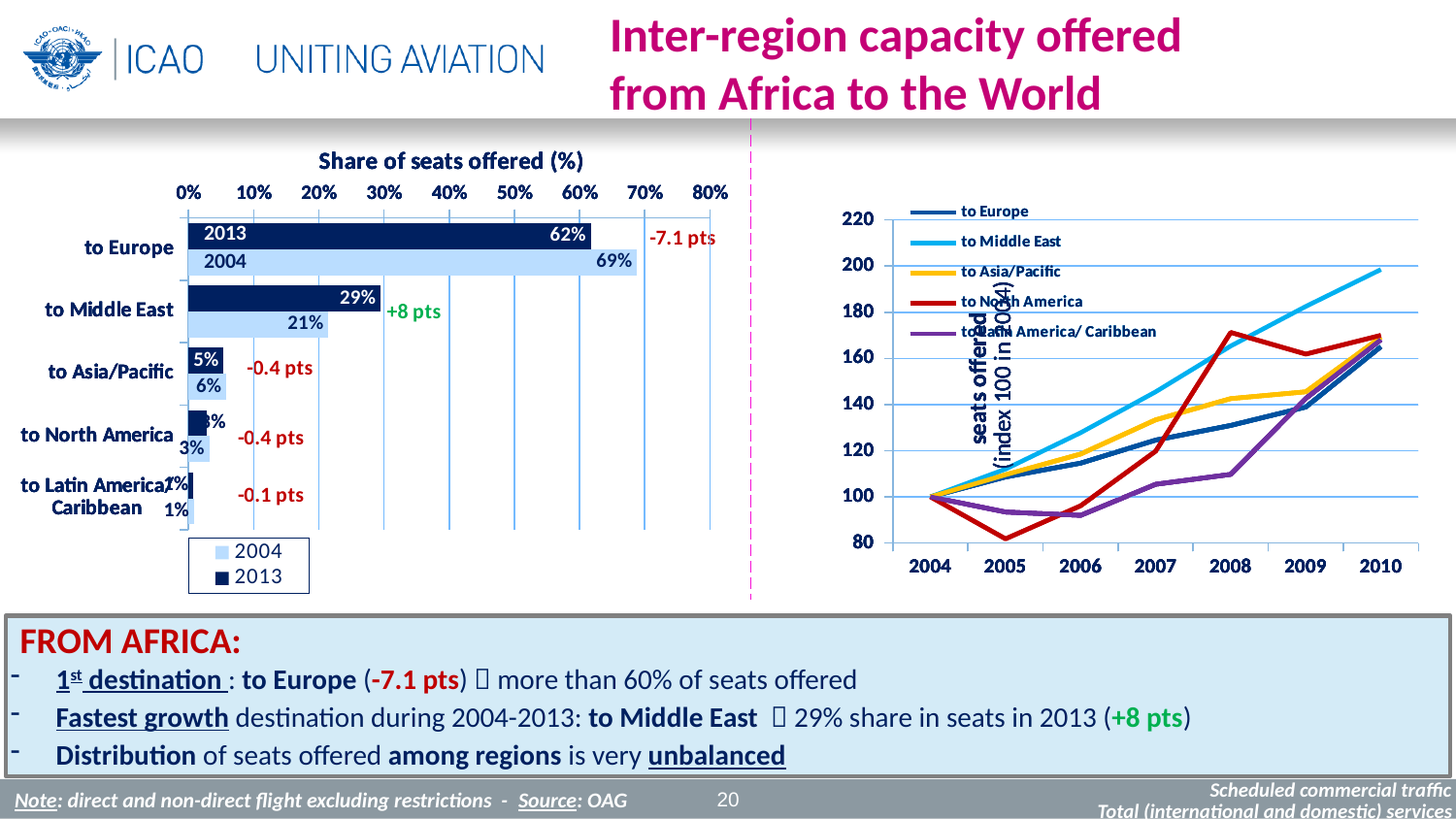
In the 'Share of seats offered (%)' bar chart, which is larger: the 2013 share for 'to Middle East' or the 2013 share for 'to Asia/Pacific'? to Middle East In the line chart on the right, how many series does the legend list? 5 What kind of chart is the chart on the left of the slide? Bar chart In the 'Share of seats offered (%)' bar chart, how many series does the legend list? 2 In the 'Share of seats offered (%)' bar chart, what is the 2013 share for 'to Europe'? 62% In the 'Share of seats offered (%)' bar chart, how many destination categories are shown? 5 In the line chart on the right, is the value for 'to Middle East' in 2010 greater or less than 180? greater In the 'Share of seats offered (%)' bar chart, which destination has the highest share in 2013? to Europe In the line chart on the right, which series has the highest value in 2010? to Middle East In the 'Share of seats offered (%)' bar chart, what is the difference between the 2004 and 2013 shares for 'to Europe'? -7.1 pts In the line chart on the right, is the value for 'to North America' in 2005 greater or less than 100? less In the 'Share of seats offered (%)' bar chart, what is the 2004 share for 'to Middle East'? 21%